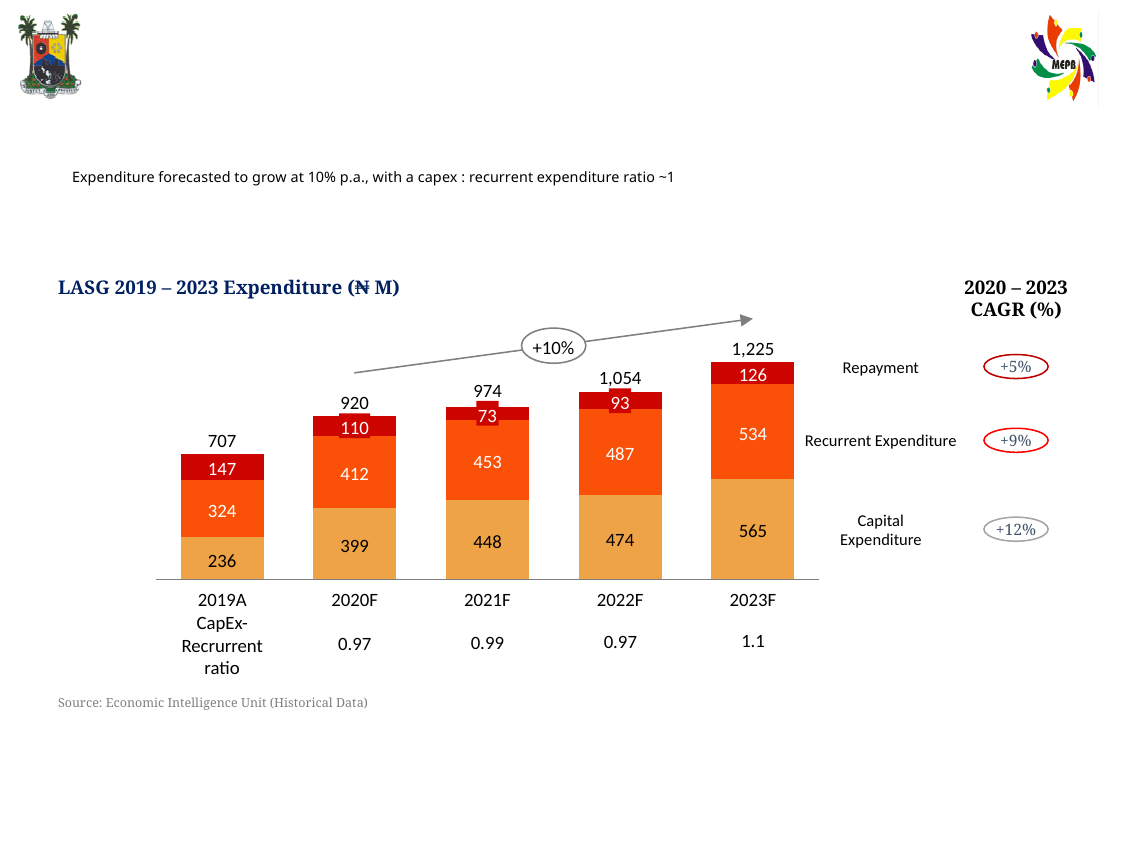
What is the difference between the total expenditure for 2023F and 2019A? 518 What is the 2020 – 2023 CAGR shown for Capital Expenditure? +12% Do total expenditure values rise or fall from 2019A to 2023F? Rise How many years are shown on the x axis of the chart? 5 Is Recurrent Expenditure in 2020F larger than Capital Expenditure in 2020F? Yes, 412 vs 399 What is the Repayment value for 2019A? 147 What kind of chart is used to show LASG 2019 – 2023 Expenditure? Stacked bar chart Which year has the highest total expenditure? 2023F What is the total expenditure shown for 2022F? 1,054 What is the Capital Expenditure value for 2021F? 448 What is the Recurrent Expenditure value for 2023F? 534 Which year has the lowest Capital Expenditure? 2019A